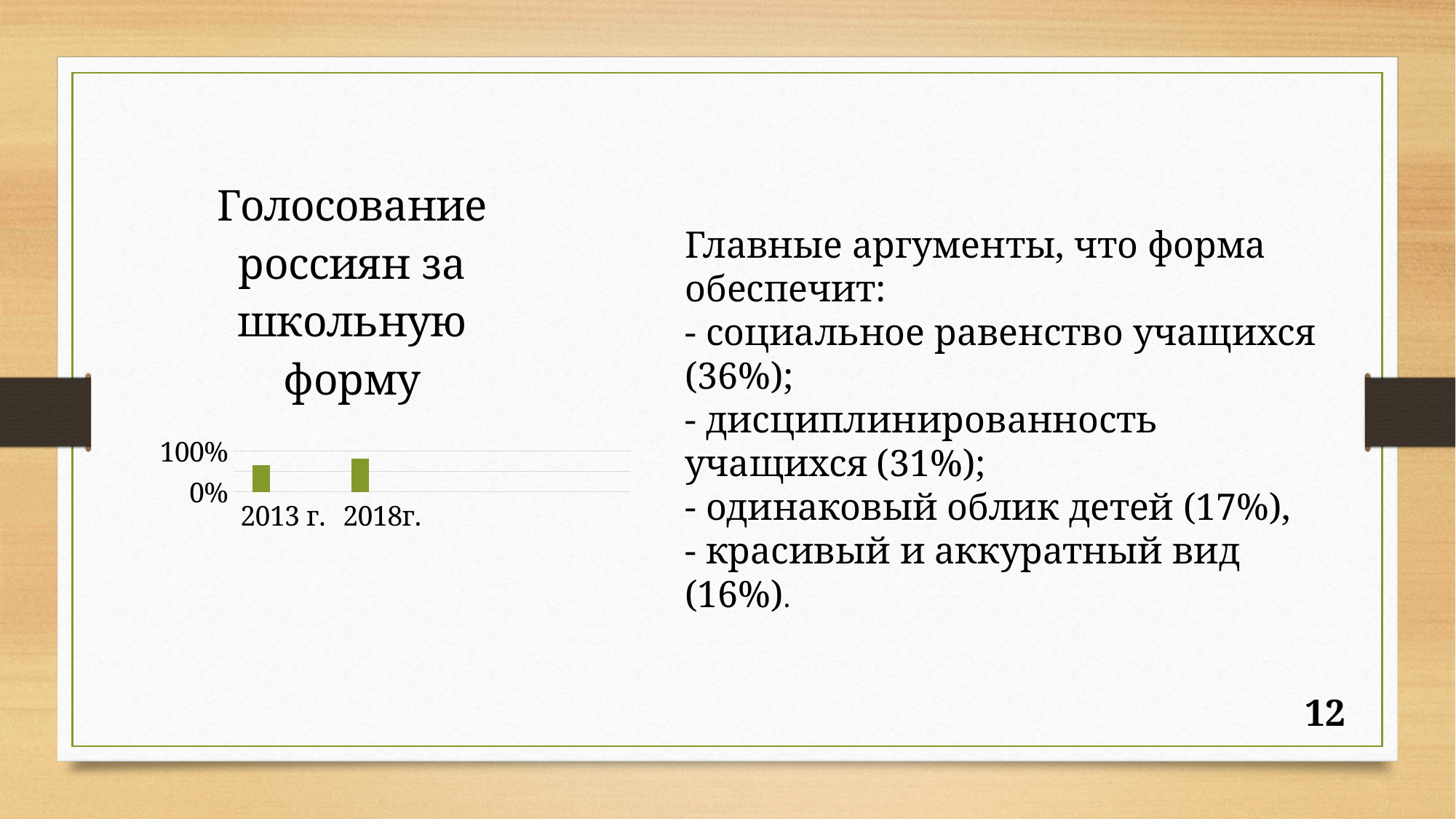
Is the value for 2013 г. greater or less than 0%? greater What are the two tick labels shown on the y axis of the chart? 0% and 100% Which category has the highest value in the chart? 2018г. What is the title of the chart on the slide? Голосование россиян за школьную форму How many categories (years) are shown on the x axis of the chart? 2 Which year has the higher bar in the chart, 2013 г. or 2018г.? 2018г. What kind of chart is shown on the slide? bar chart Do the values in the chart rise or fall from 2013 г. to 2018г.? rise Is the value for 2018г. greater or less than 100%? less Which category has the lowest value in the chart? 2013 г.